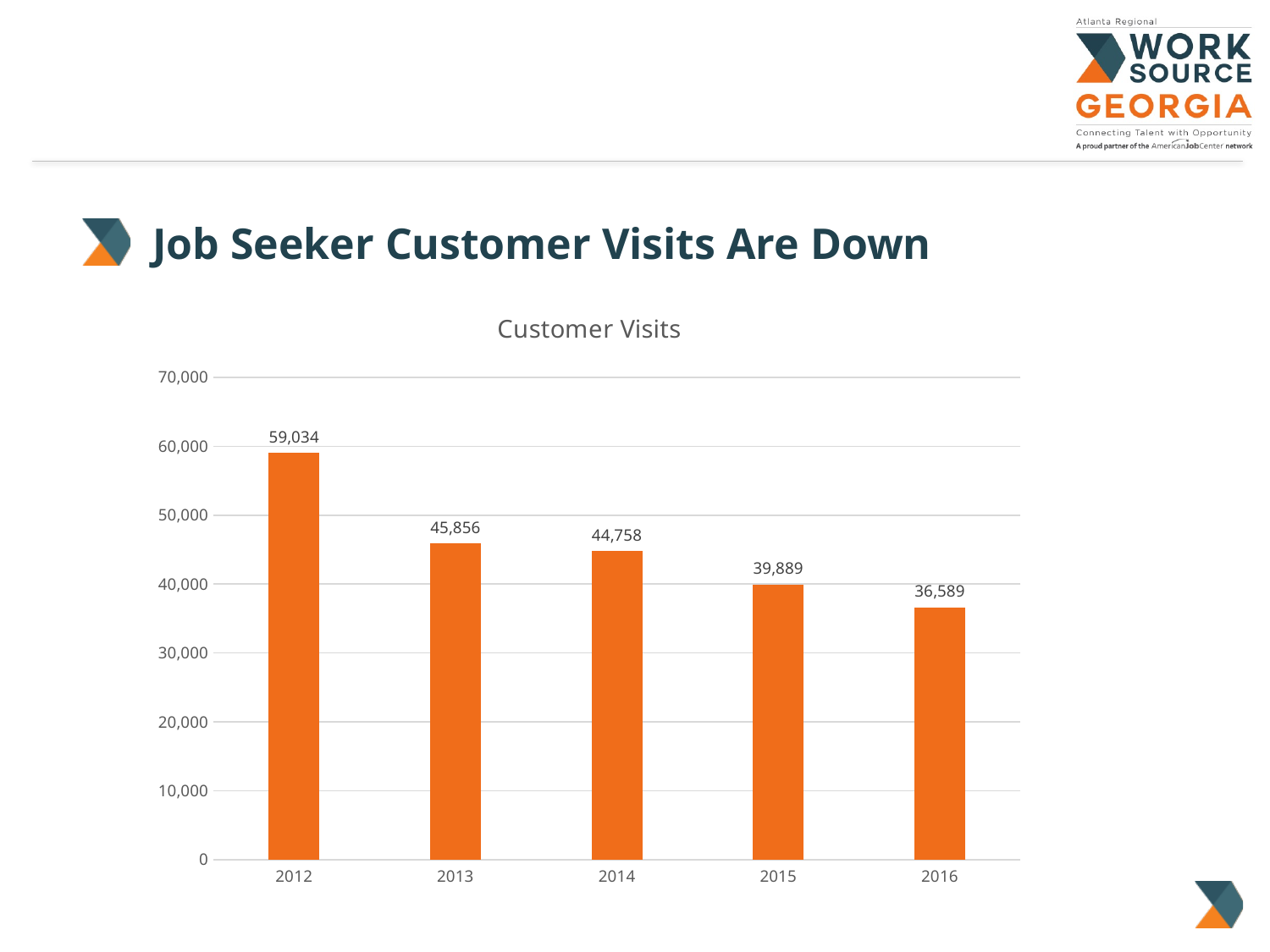
What is the value of customer visits for 2012? 59,034 What kind of chart is shown on the slide? bar chart What is the value of customer visits for 2016? 36,589 Is the value for 2015 greater or less than 40,000? less Which year has the highest number of customer visits? 2012 What is the difference in customer visits between 2013 and 2014? 1,098 Which year had more customer visits, 2013 or 2015? 2013 Do customer visits rise or fall from 2012 to 2016? fall What is the value of customer visits for 2014? 44,758 Which year has the lowest number of customer visits? 2016 What is the difference in customer visits between 2012 and 2016? 22,445 How many years are shown on the x axis of the chart? 5